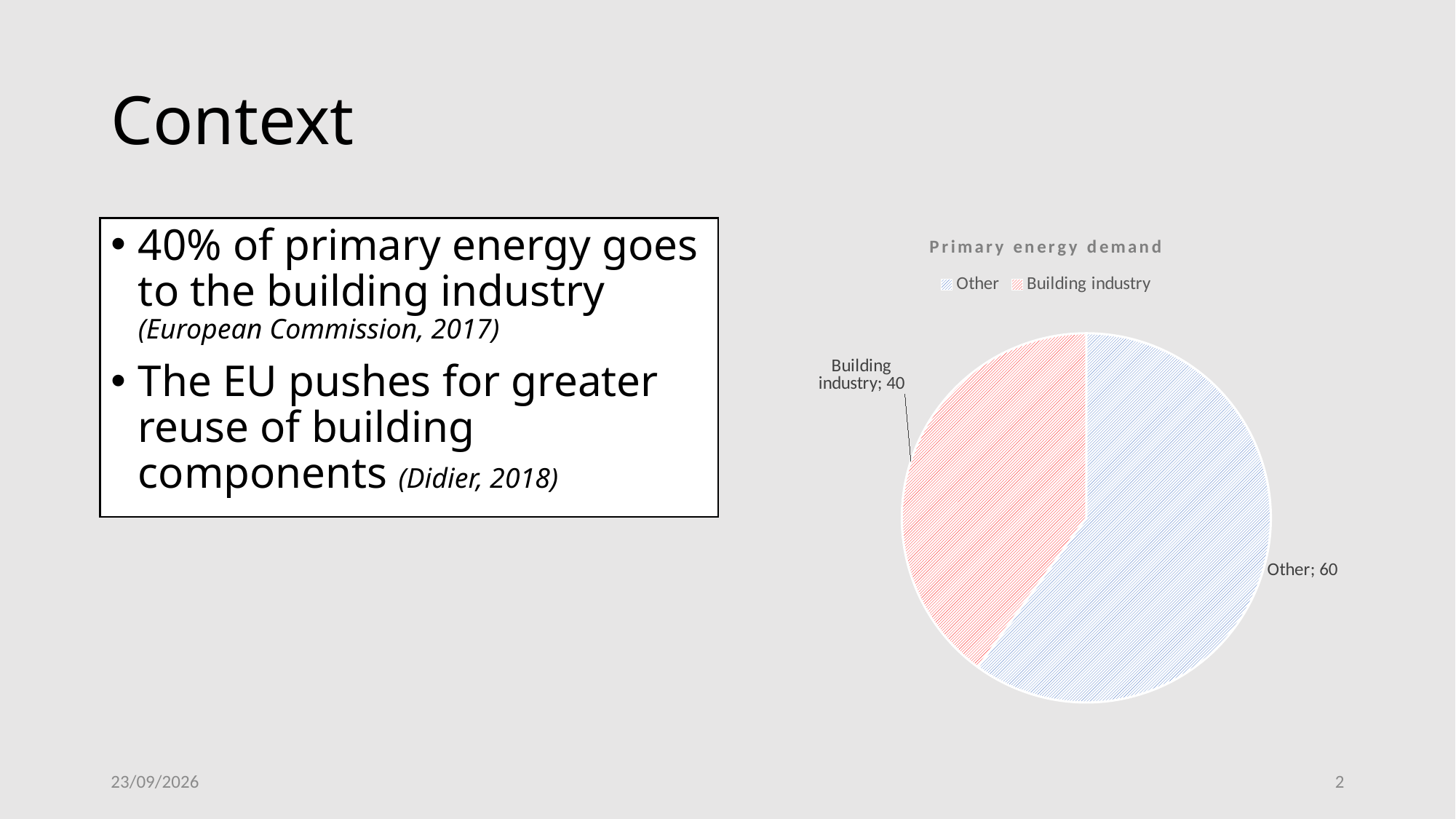
What kind of chart is shown on the slide? Pie chart How many entries does the chart legend list? 2 What is the value for Other in the pie chart? 60 Which slice of the pie chart is the largest? Other Which slice of the pie chart is the smallest? Building industry What is the difference between the values for Other and Building industry? 20 What is the value for Building industry in the pie chart? 40 What share of the pie does the Building industry slice represent? 40% What is the title of the chart? Primary energy demand Which is larger, the value for Other or the value for Building industry? Other Which legend entry is shown with red hatching? Building industry How many slices does the pie chart have? 2